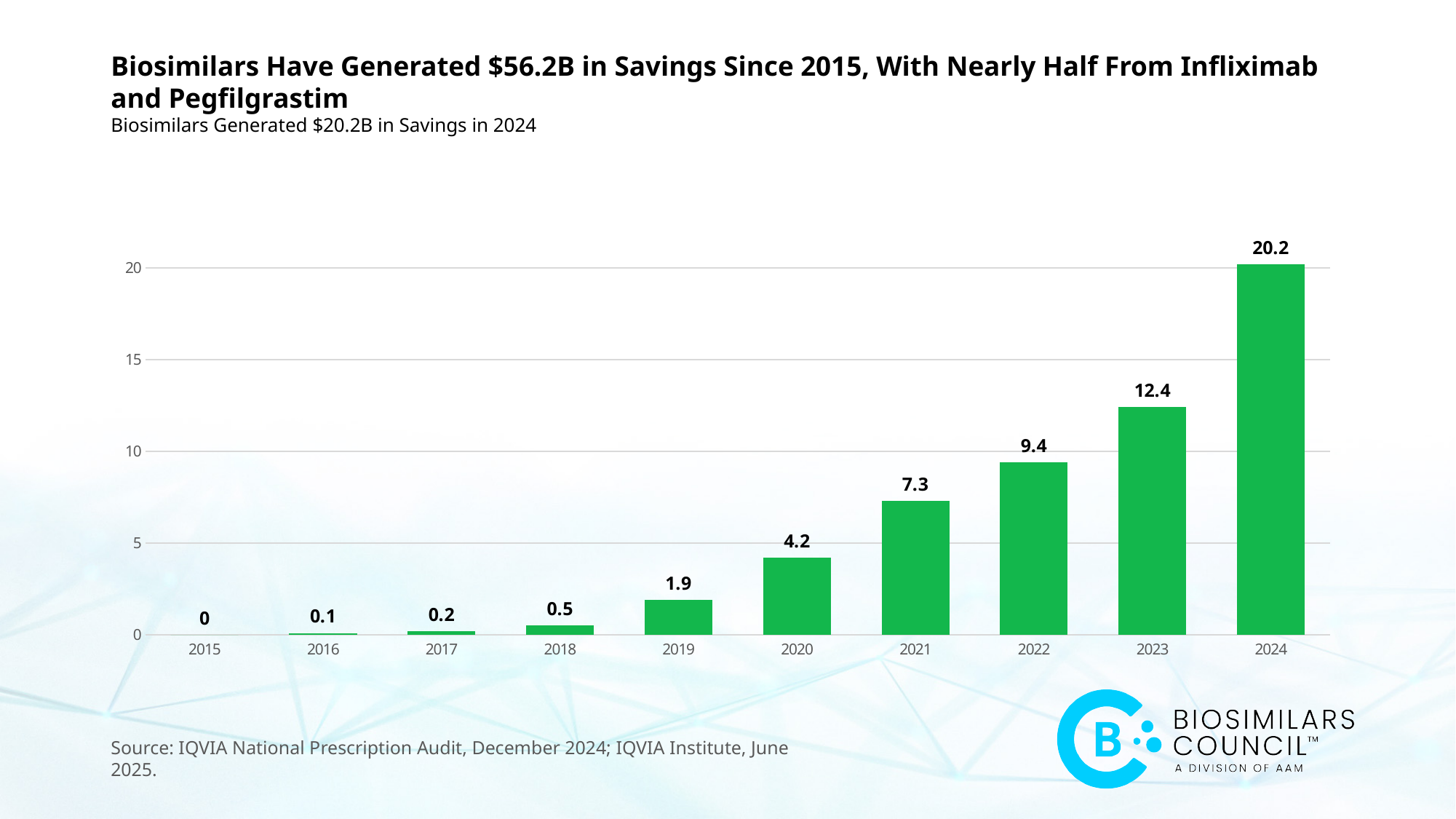
Which year has the lowest value? 2015 Which year has the highest value? 2024 What is the difference between the values for 2024 and 2023? 7.8 How many years are shown on the x axis? 10 Do the values rise or fall from 2015 to 2024? Rise What is the value shown for 2021? 7.3 What is the value shown for 2019? 1.9 Is the value for 2023 greater or less than 10? greater Which is larger, the value for 2021 or the value for 2022? 2022 What is the difference between the values for 2022 and 2020? 5.2 What is the value shown for 2024? 20.2 What kind of chart is shown on the slide? Bar chart